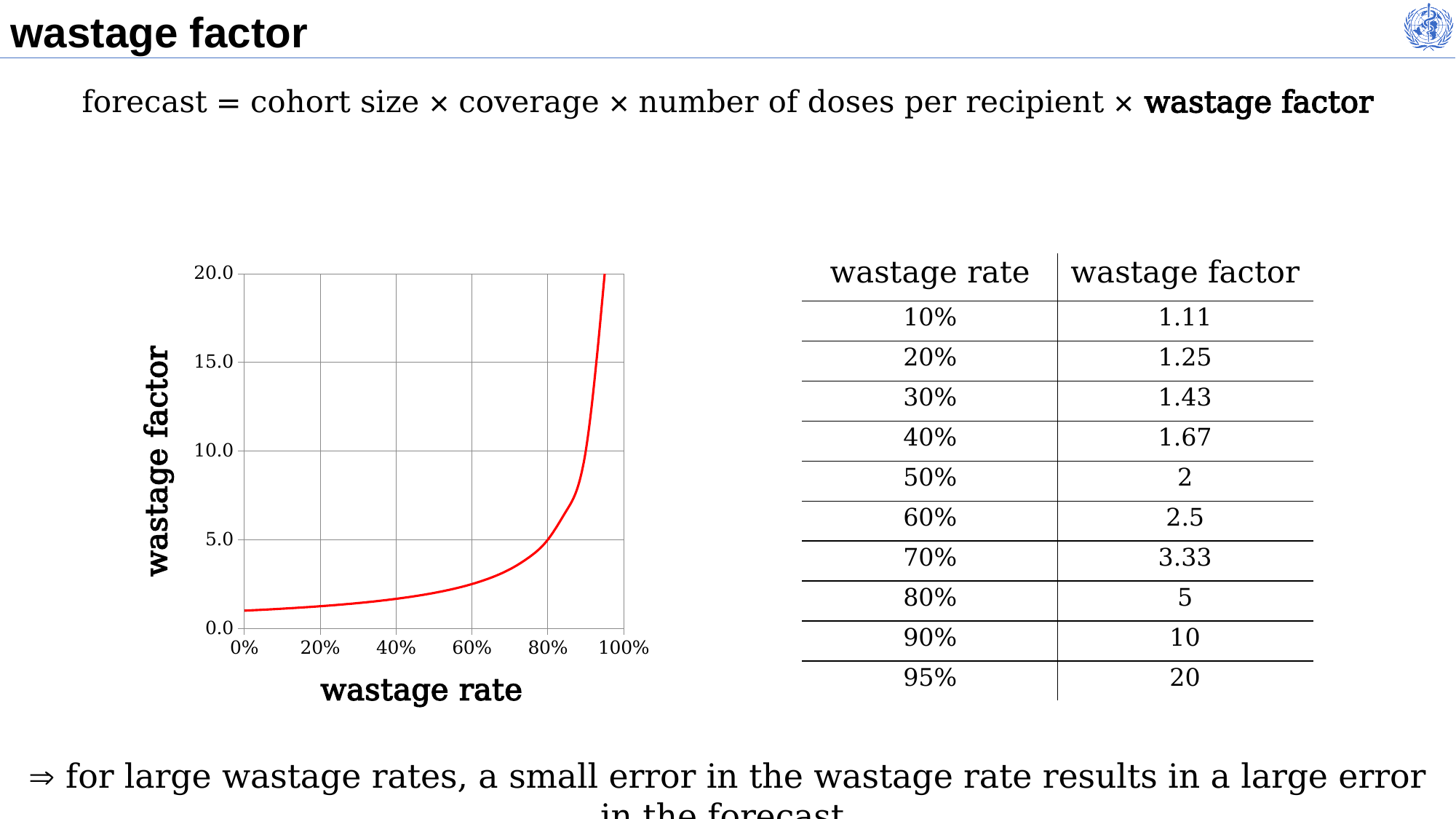
What is the label of the x axis of the chart? wastage rate Is the wastage factor at a wastage rate of 95% greater or less than 15.0? greater Is the wastage factor at a wastage rate of 20% greater or less than 5.0? less Is the wastage factor at a wastage rate of 40% greater or less than 5.0? less What is the wastage factor at a wastage rate of 90%? 10.0 Which has the larger wastage factor, a wastage rate of 60% or a wastage rate of 90%? 90% Does the wastage factor rise or fall as the wastage rate increases along the x axis? rise What is the wastage factor at a wastage rate of 80%? 5.0 What kind of chart is shown on the slide? line chart What is the label of the y axis of the chart? wastage factor What is the highest value shown on the y axis of the chart? 20.0